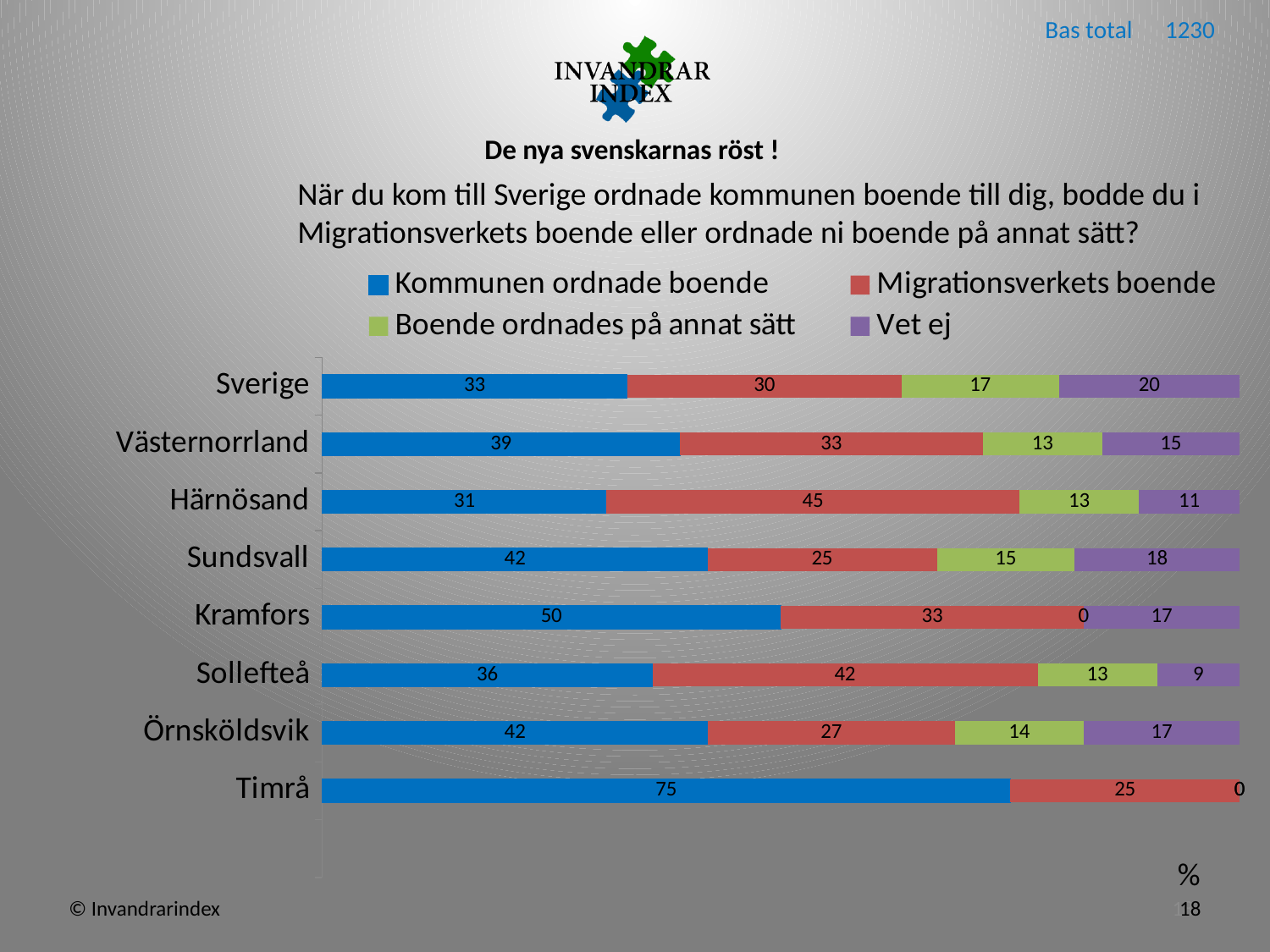
What is the value of "Migrationsverkets boende" for Härnösand? 45 What is the total of the stacked bar for Sverige? 100 What is the value of "Kommunen ordnade boende" for Kramfors? 50 Which category has the highest value for "Migrationsverkets boende"? Härnösand How many categories are shown on the y axis of the chart? 8 Which category has the highest value for "Kommunen ordnade boende"? Timrå For Sundsvall, which is larger: "Kommunen ordnade boende" or "Migrationsverkets boende"? Kommunen ordnade boende For Sverige, what is the difference between "Kommunen ordnade boende" and "Migrationsverkets boende"? 3 What is the "Vet ej" value for Sollefteå? 9 What colour represents "Vet ej" in the legend? Purple What kind of chart is shown on the slide? Stacked bar chart How many series does the legend list? 4